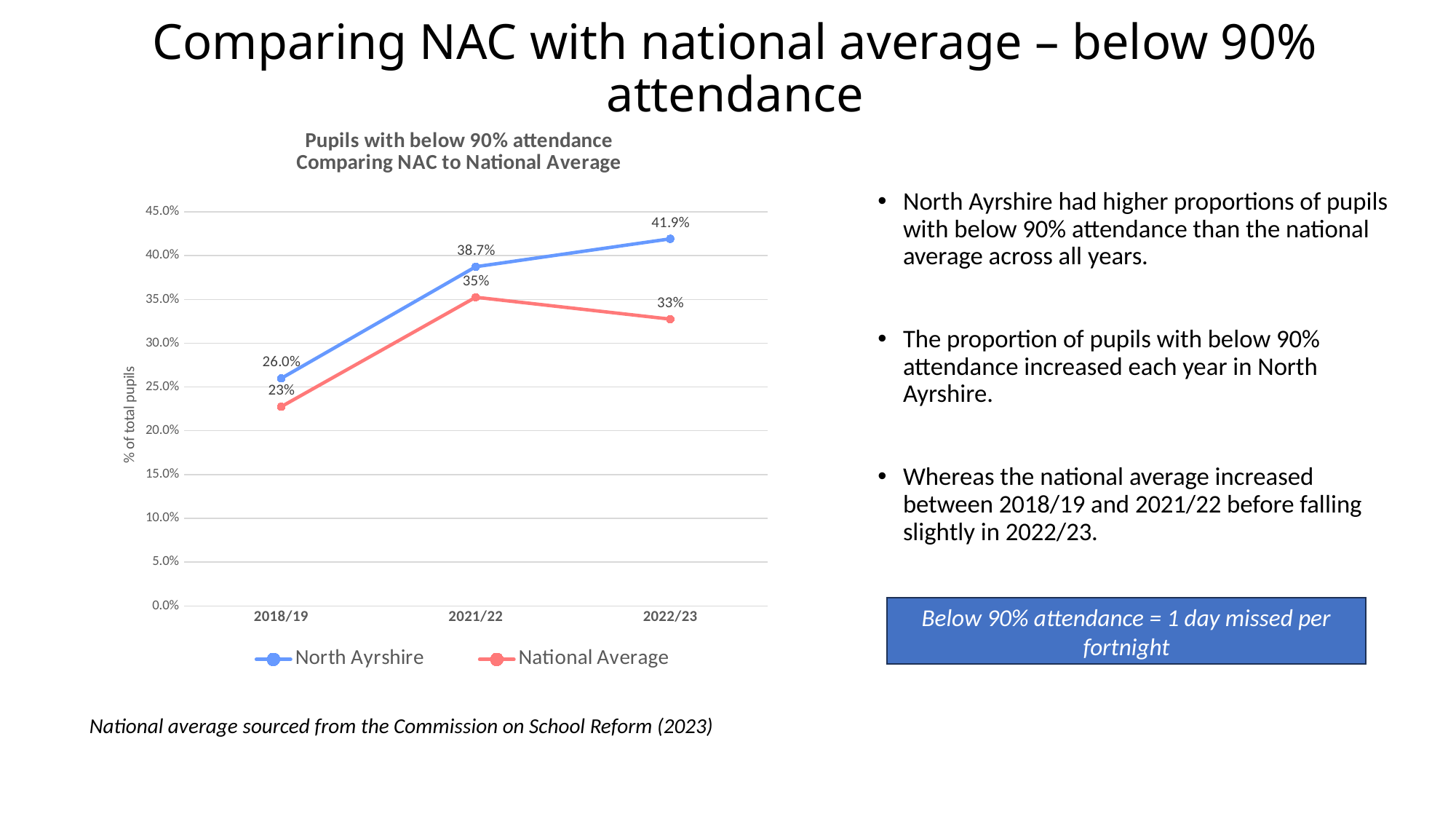
In which year is the National Average value lowest? 2018/19 What kind of chart is shown on the slide? Line chart What is the difference between North Ayrshire and the National Average in 2022/23? 8.9% Which series has the larger value in 2021/22, North Ayrshire or National Average? North Ayrshire In which year is the North Ayrshire value highest? 2022/23 What is the value for North Ayrshire in 2021/22? 38.7% What is the value for the National Average in 2022/23? 33% How many years are shown on the x axis? 3 What is the value for North Ayrshire in 2022/23? 41.9% What is the value for the National Average in 2018/19? 23% Does the North Ayrshire series rise or fall from 2018/19 to 2022/23? Rise How many series does the legend list? 2